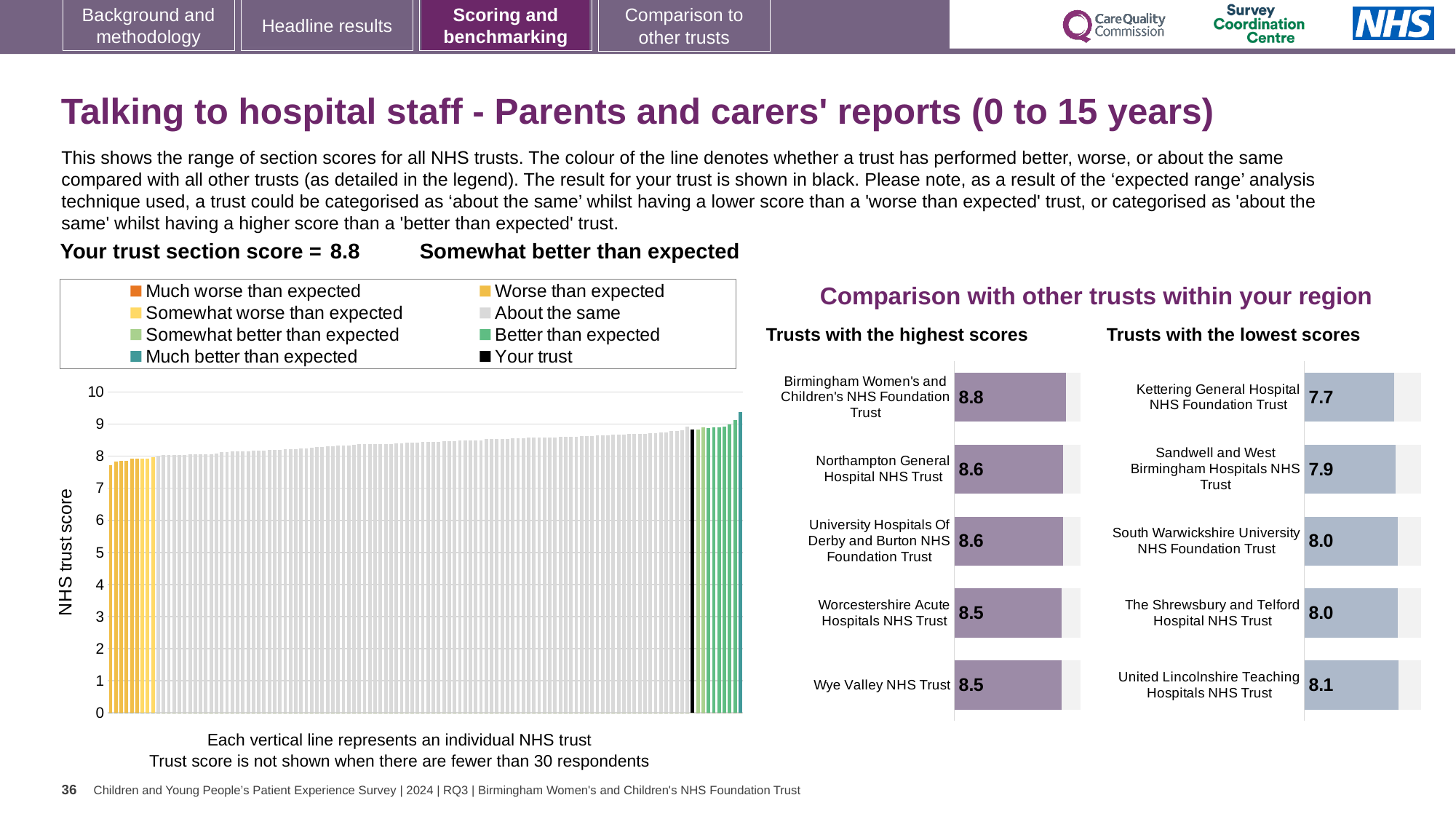
In the 'Trusts with the highest scores' chart, what is the difference between the scores of Birmingham Women's and Children's NHS Foundation Trust and Wye Valley NHS Trust? 0.3 What kind of chart is the main chart on the left showing the range of section scores? Bar chart In the 'Trusts with the lowest scores' chart, which trust has the lowest score? Kettering General Hospital NHS Foundation Trust How many entries does the legend of the main chart on the left list? 8 In the 'Trusts with the lowest scores' chart, what is the score for United Lincolnshire Teaching Hospitals NHS Trust? 8.1 In the 'Trusts with the highest scores' chart, what is the score for Birmingham Women's and Children's NHS Foundation Trust? 8.8 In the 'Trusts with the lowest scores' chart, which has the higher score: Sandwell and West Birmingham Hospitals NHS Trust or United Lincolnshire Teaching Hospitals NHS Trust? United Lincolnshire Teaching Hospitals NHS Trust In the 'Trusts with the highest scores' chart, what is the score for Worcestershire Acute Hospitals NHS Trust? 8.5 In the main chart on the left, is the value for the lowest-scoring trust greater or less than 8? less In the 'Trusts with the highest scores' chart, which trust has the highest score? Birmingham Women's and Children's NHS Foundation Trust In the 'Trusts with the lowest scores' chart, what is the score for Kettering General Hospital NHS Foundation Trust? 7.7 How many trusts are shown in the 'Trusts with the lowest scores' chart? 5